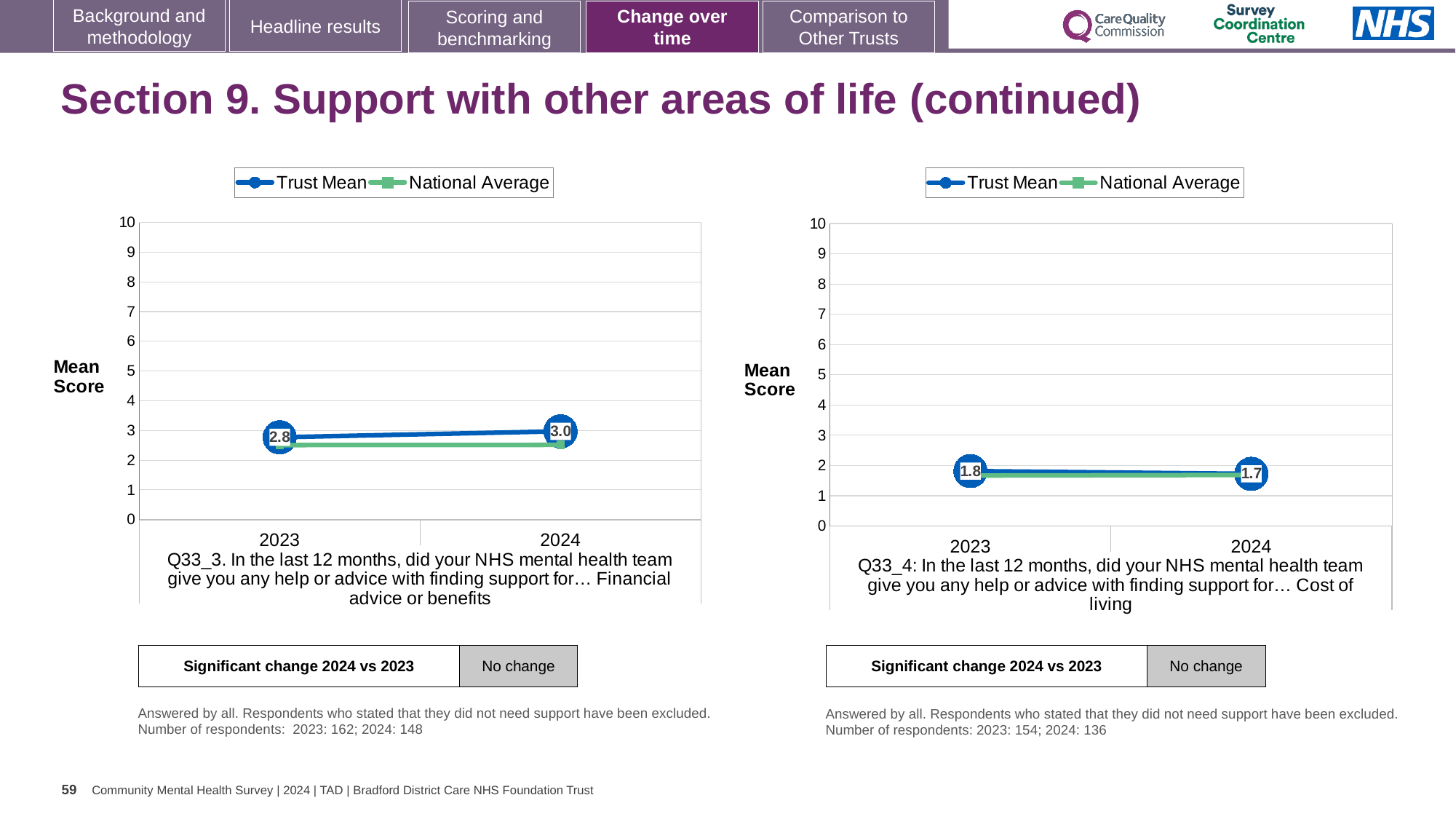
In the right chart (Q33_4), what is the difference between the Trust Mean in 2023 and in 2024? 0.1 In the left chart (Q33_3), by how much did the Trust Mean change from 2023 to 2024? 0.2 What kind of chart is the right chart (Q33_4, Cost of living)? line chart In the right chart (Q33_4), does the Trust Mean rise or fall from 2023 to 2024? fall In the left chart (Q33_3, Financial advice or benefits), what is the Trust Mean for 2023? 2.8 In the left chart (Q33_3, Financial advice or benefits), what is the Trust Mean for 2024? 3.0 In the right chart (Q33_4, Cost of living), what is the Trust Mean for 2024? 1.7 In the right chart (Q33_4), is the National Average for 2023 greater or less than 1? greater How many series does the legend of the left chart list? 2 In the left chart (Q33_3), does the Trust Mean rise or fall from 2023 to 2024? rise In the left chart (Q33_3), is the National Average for 2024 greater or less than 3? less In the right chart (Q33_4, Cost of living), what is the Trust Mean for 2023? 1.8